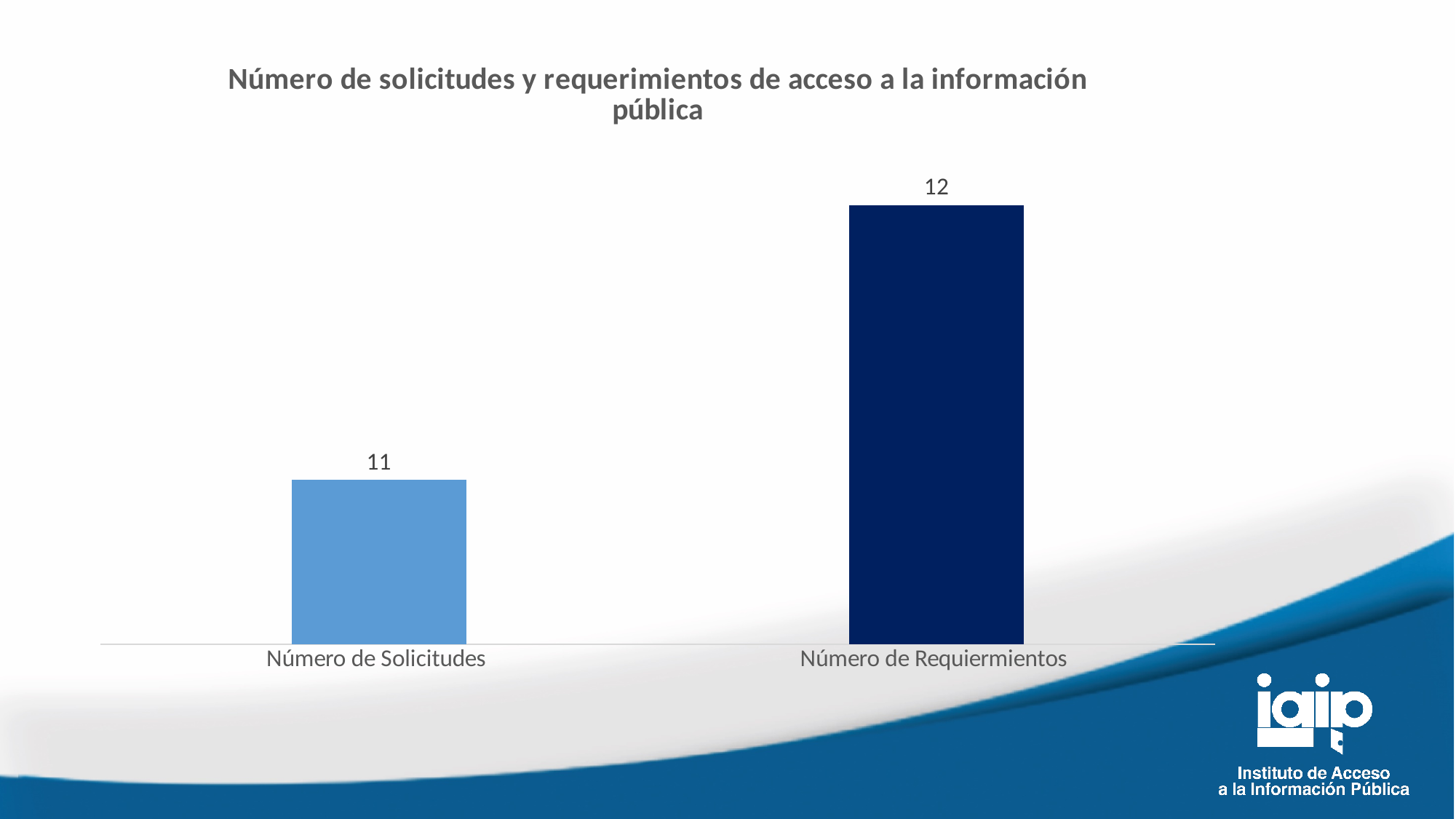
What is the title of the chart? Número de solicitudes y requerimientos de acceso a la información pública What kind of chart is shown on the slide? Bar chart What is the difference between the values for Número de Requiermientos and Número de Solicitudes? 1 Which is larger, the value for Número de Solicitudes or the value for Número de Requiermientos? Número de Requiermientos What is the value for Número de Solicitudes? 11 What colour is the bar for Número de Requiermientos? Dark navy blue How many categories are shown in the chart? 2 Which category has the highest value? Número de Requiermientos What is the value for Número de Requiermientos? 12 Which category has the lowest value? Número de Solicitudes What is the total of the two values shown in the chart? 23